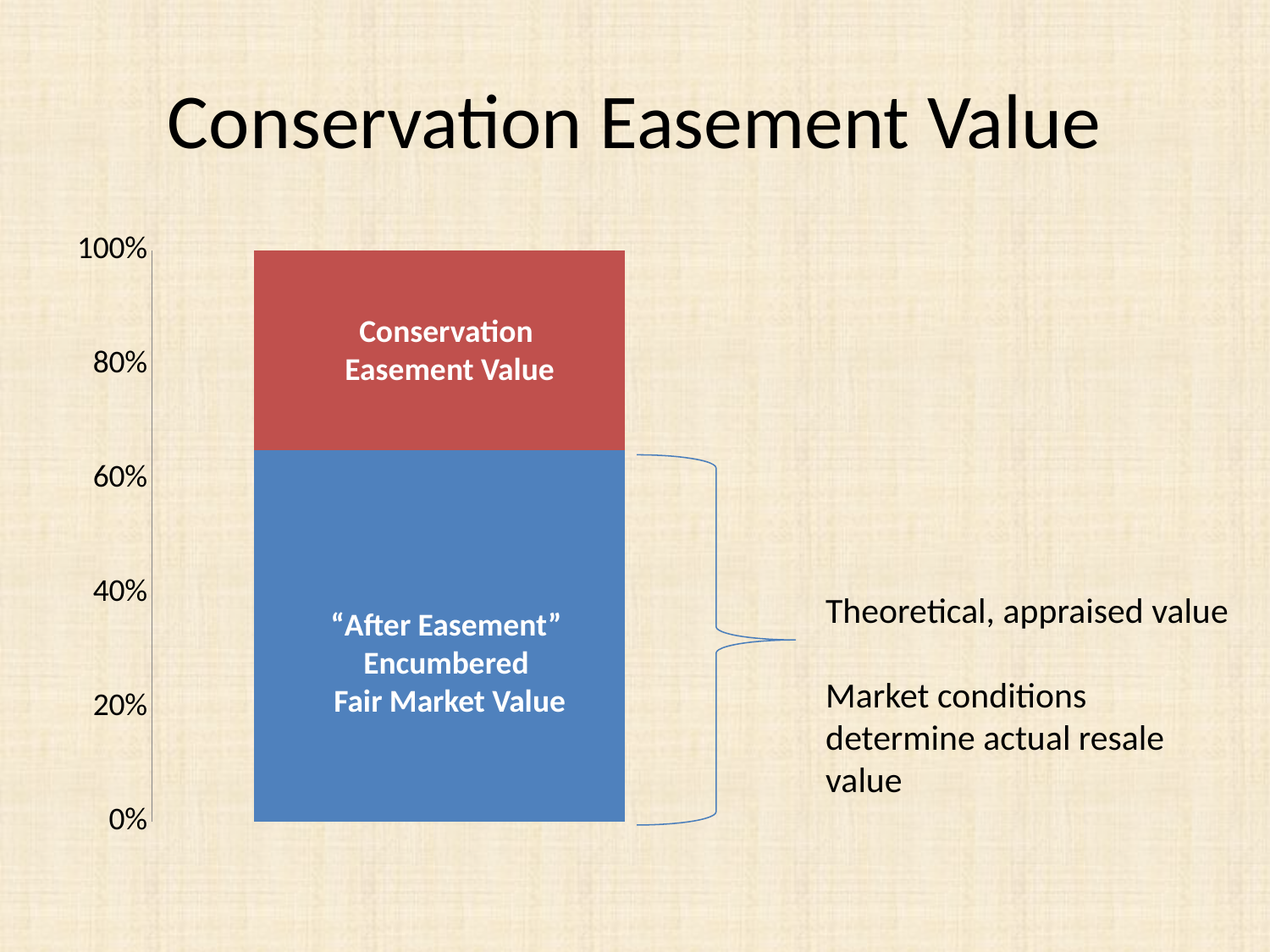
Which segment of the bar is the smallest? Conservation Easement Value Is the "After Easement" Encumbered Fair Market Value segment greater or less than 80%? less What is the highest value shown on the vertical axis? 100% Is the "After Easement" Encumbered Fair Market Value segment greater or less than 60%? greater Is the Conservation Easement Value segment greater or less than 40%? less How many segments make up the stacked bar? 2 What is the total height of the stacked bar on the percentage axis? 100% Which segment of the bar is larger, "Conservation Easement Value" or "After Easement" Encumbered Fair Market Value? "After Easement" Encumbered Fair Market Value What kind of chart is shown on the slide? Stacked bar chart What colour is the "After Easement" Encumbered Fair Market Value segment? Blue Which segment of the bar is the largest? "After Easement" Encumbered Fair Market Value